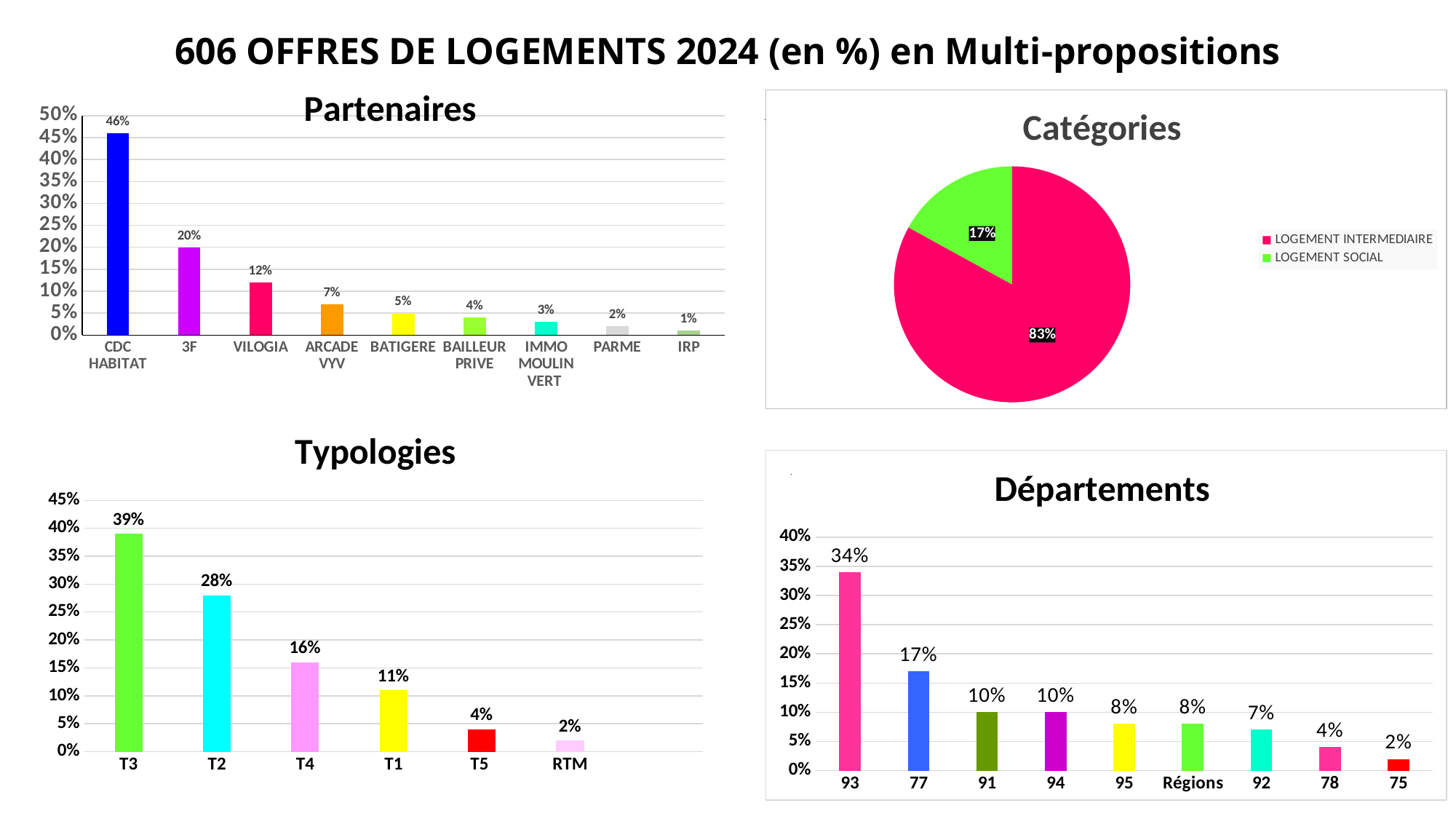
In the Départements chart, what is the value for 77? 17% In the Typologies chart, which typology has the highest value? T3 What kind of chart is the Catégories chart? pie chart In the Catégories chart, how many entries does the legend list? 2 In the Partenaires chart, what is the value for CDC HABITAT? 46% In the Partenaires chart, how many partners are shown? 9 In the Partenaires chart, what is the difference between the values for 3F and VILOGIA? 8% In the Partenaires chart, which partner has the lowest value? IRP In the Typologies chart, what is the value for T4? 16% In the Départements chart, which is larger, the value for 95 or the value for 78? 95 In the Catégories pie chart, what share does LOGEMENT SOCIAL have? 17% In the Typologies chart, do the values rise or fall from left to right along the x axis? fall